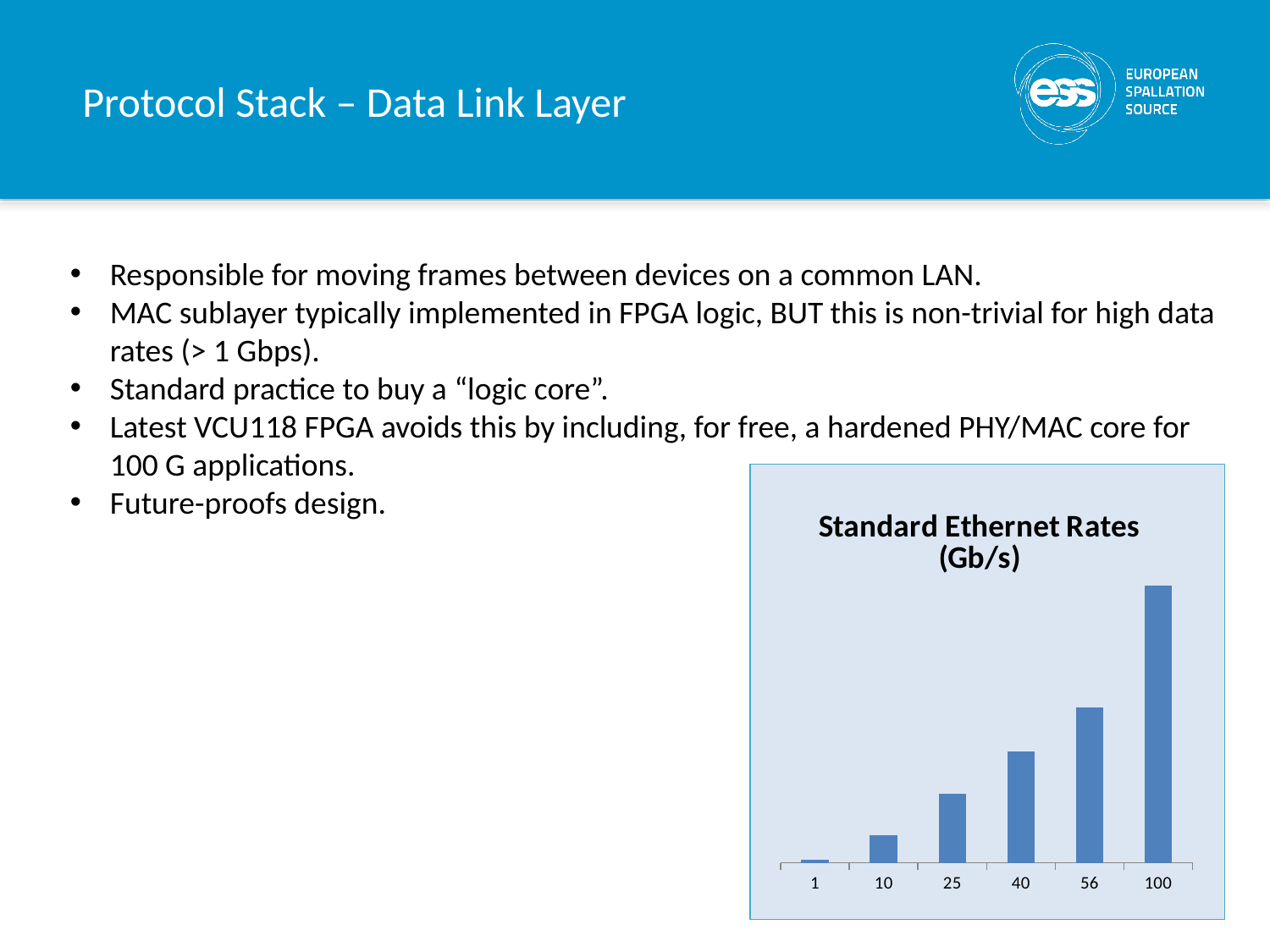
What type of chart is shown on the slide? bar chart Which category has the shortest bar in the chart? 1 Which bar is taller, the one for 10 or the one for 25? 25 Which bar is taller, the one for 1 or the one for 100? 100 What are the category labels on the x axis, from left to right? 1, 10, 25, 40, 56, 100 What is the title of the chart? Standard Ethernet Rates (Gb/s) Which bar is taller, the one for 40 or the one for 56? 56 Which category has the tallest bar in the chart? 100 Do the bar heights rise or fall from left to right along the x axis? rise How many bars are plotted in the chart? 6